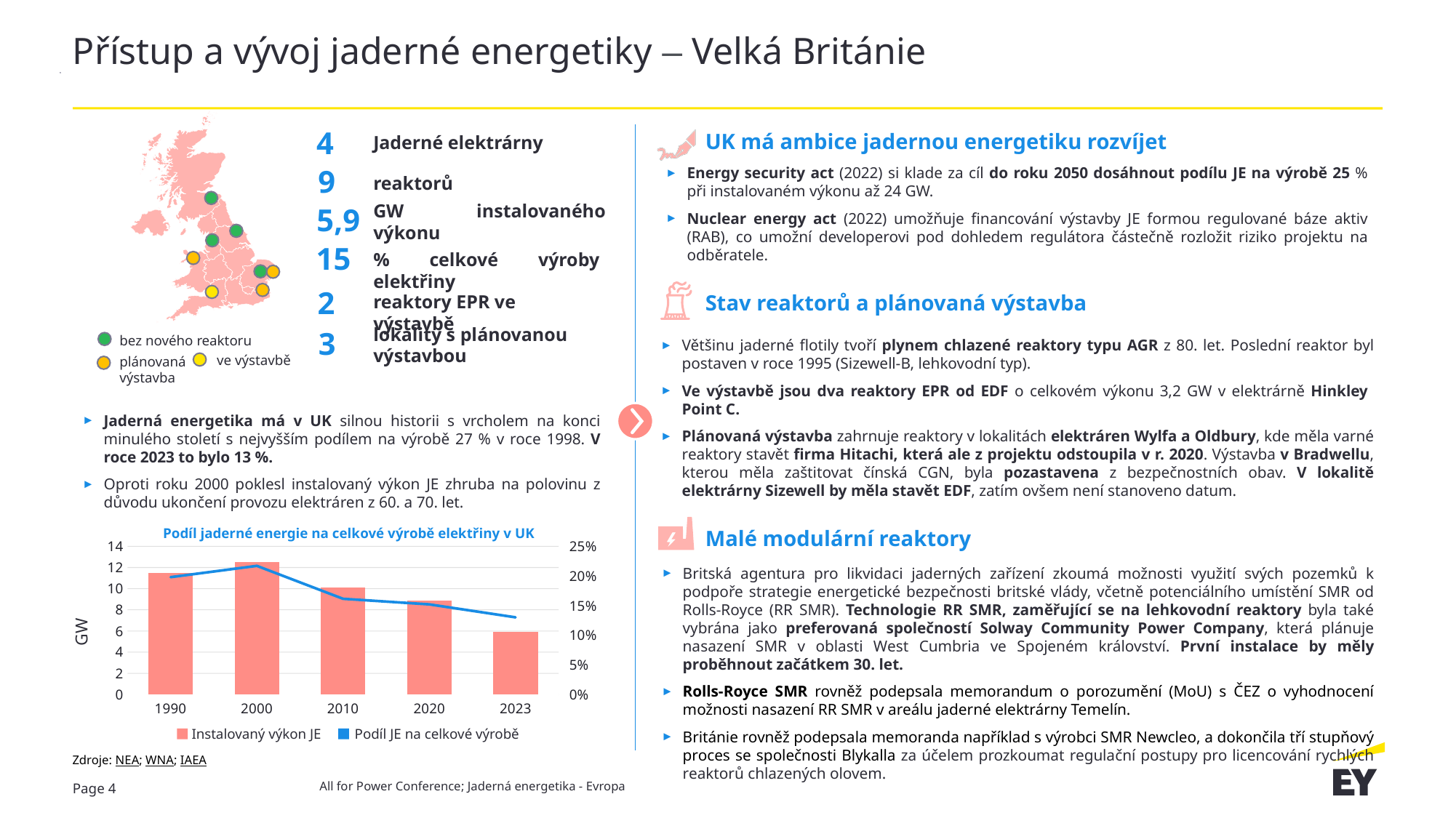
Is the Instalovaný výkon JE bar for 1990 greater or less than 10 GW? greater Is the Instalovaný výkon JE bar for 2023 greater or less than 8 GW? less Is the Instalovaný výkon JE bar for 2020 greater or less than 10 GW? less Does the Podíl JE na celkové výrobě line rise or fall from 2000 to 2023? fall Which year has the highest bar for Instalovaný výkon JE? 2000 Which year has a larger Instalovaný výkon JE bar, 1990 or 2020? 1990 How many years are shown on the x axis of the chart? 5 How many series does the chart legend list? 2 What is the title of the chart on the slide? Podíl jaderné energie na celkové výrobě elektřiny v UK Which year has the lowest bar for Instalovaný výkon JE? 2023